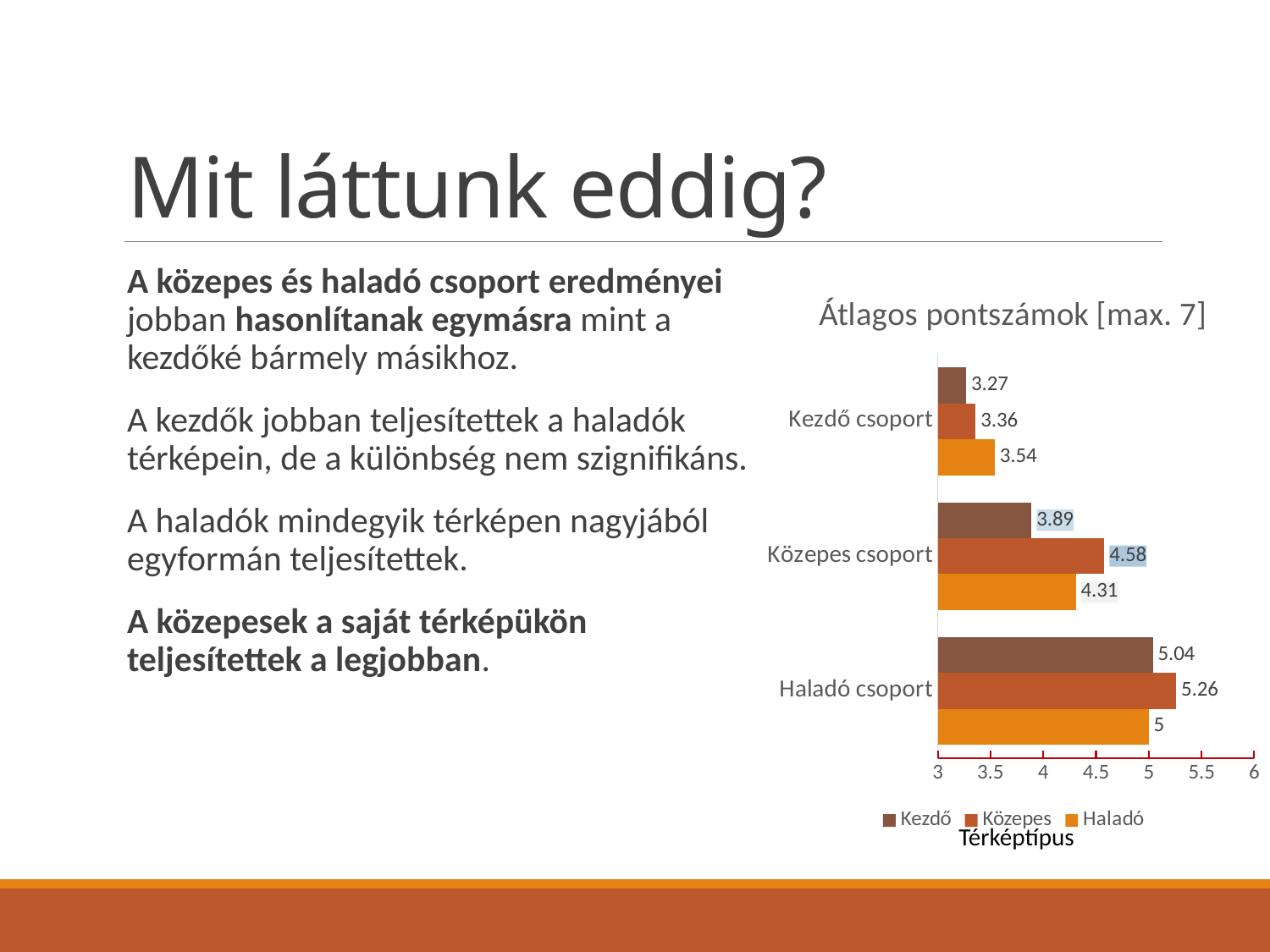
What is the value of the Haladó series for Kezdő csoport? 3.54 Which category has the lowest value for the Kezdő series? Kezdő csoport Which category has the highest value for the Közepes series? Haladó csoport How many series does the legend list? 3 What is the difference between the Közepes and Kezdő series values for Közepes csoport? 0.69 For Haladó csoport, which is larger: the Közepes series value or the Haladó series value? Közepes Is the Haladó series value for Közepes csoport greater or less than 4? greater What is the value of the Kezdő series for Haladó csoport? 5.04 What kind of chart is shown on the slide? bar chart How many categories are shown on the chart? 3 What is the title of the chart? Átlagos pontszámok [max. 7] What is the value of the Közepes series for Közepes csoport? 4.58